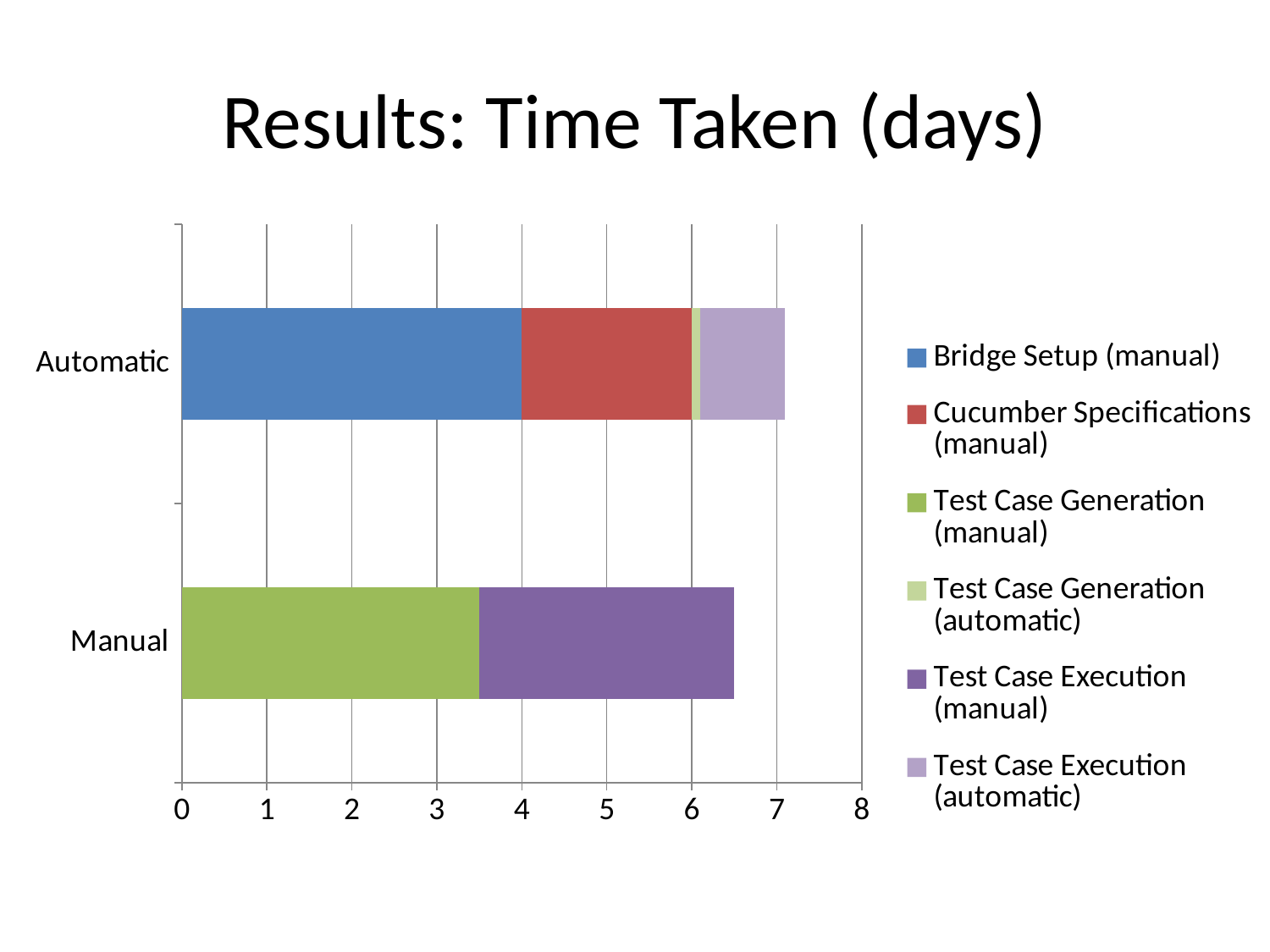
Is the total value for the Manual bar greater or less than 6? greater Is the total value for the Automatic bar greater or less than 6? greater How many days does the Bridge Setup (manual) segment of the Automatic bar span? 4 Which category has the longer total bar, Automatic or Manual? Automatic Is the Test Case Generation (manual) segment of the Manual bar greater or less than 3? greater What is the title of the chart? Results: Time Taken (days) What kind of chart is shown on the slide? Stacked bar chart What colour represents Bridge Setup (manual) in the legend? Blue Which series forms the smallest segment in the Automatic bar? Test Case Generation (automatic) How many series does the legend list? 6 How many categories are shown on the vertical axis? 2